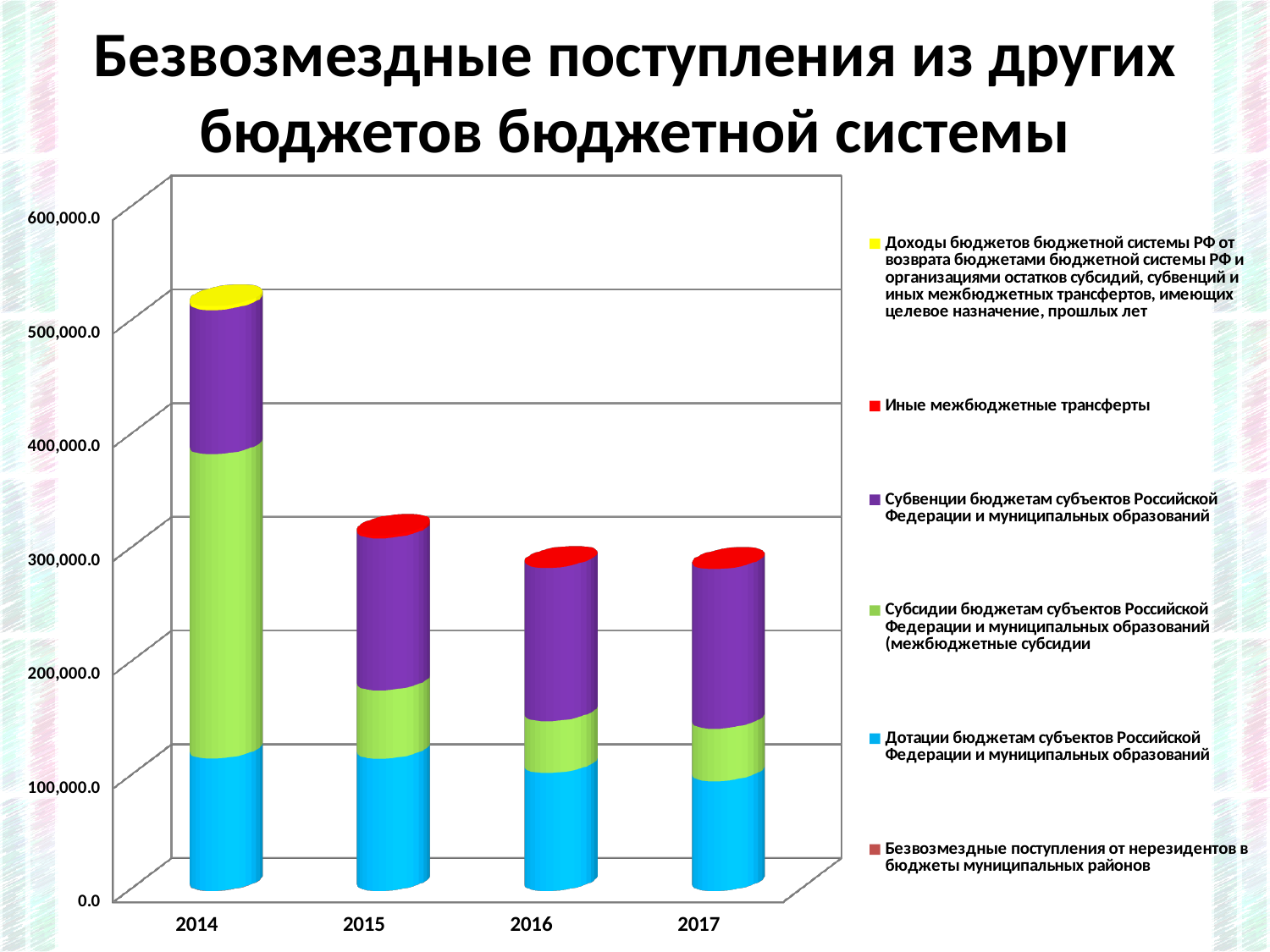
Which year has the larger total, 2014 or 2015? 2014 What is the title of the slide? Безвозмездные поступления из других бюджетов бюджетной системы Do the stacked bar totals generally rise or fall from 2014 to 2017? fall Is the total for 2016 greater or less than 400,000.0? less What kind of chart is shown on the slide? stacked bar chart Which colour represents the series "Иные межбюджетные трансферты" in the legend? red Is the total for 2014 greater or less than 500,000.0? greater How many series does the legend list? 6 How many years are shown on the x axis of the chart? 4 Is the total for 2015 greater or less than 300,000.0? greater Which year has the tallest stacked bar? 2014